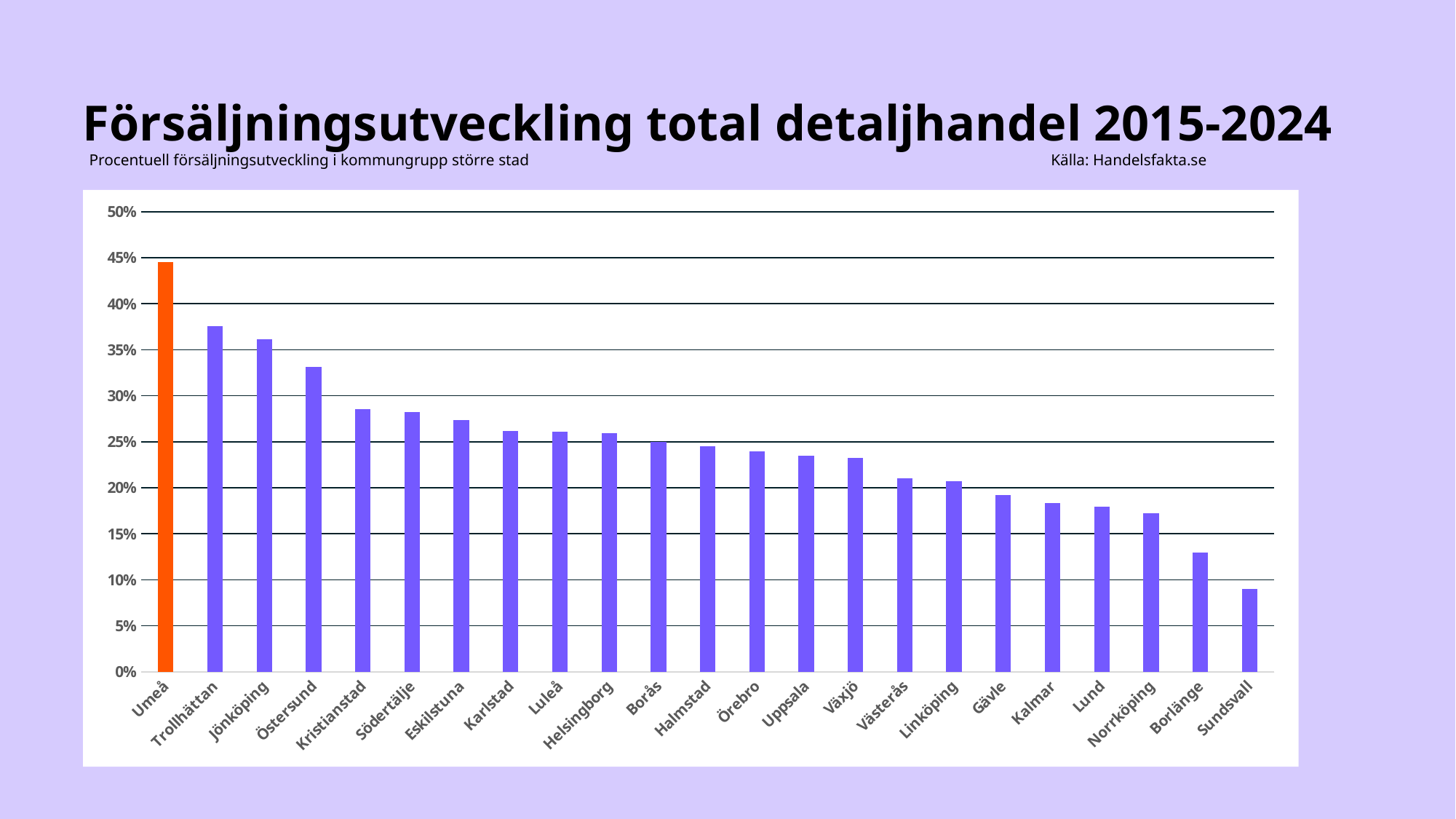
Is the value for Borlänge greater or less than 15%? less Is the value for Sundsvall greater or less than 10%? less Which has the larger value, Jönköping or Östersund? Jönköping Which municipality has the lowest value in the chart? Sundsvall Do the values rise or fall moving from left to right along the x axis? fall Is the value for Gävle greater or less than 20%? less Which municipality has the highest value in the chart? Umeå What kind of chart is shown on the slide? bar chart Which bar in the chart is coloured orange instead of purple? Umeå How many municipalities are shown on the x axis of the chart? 23